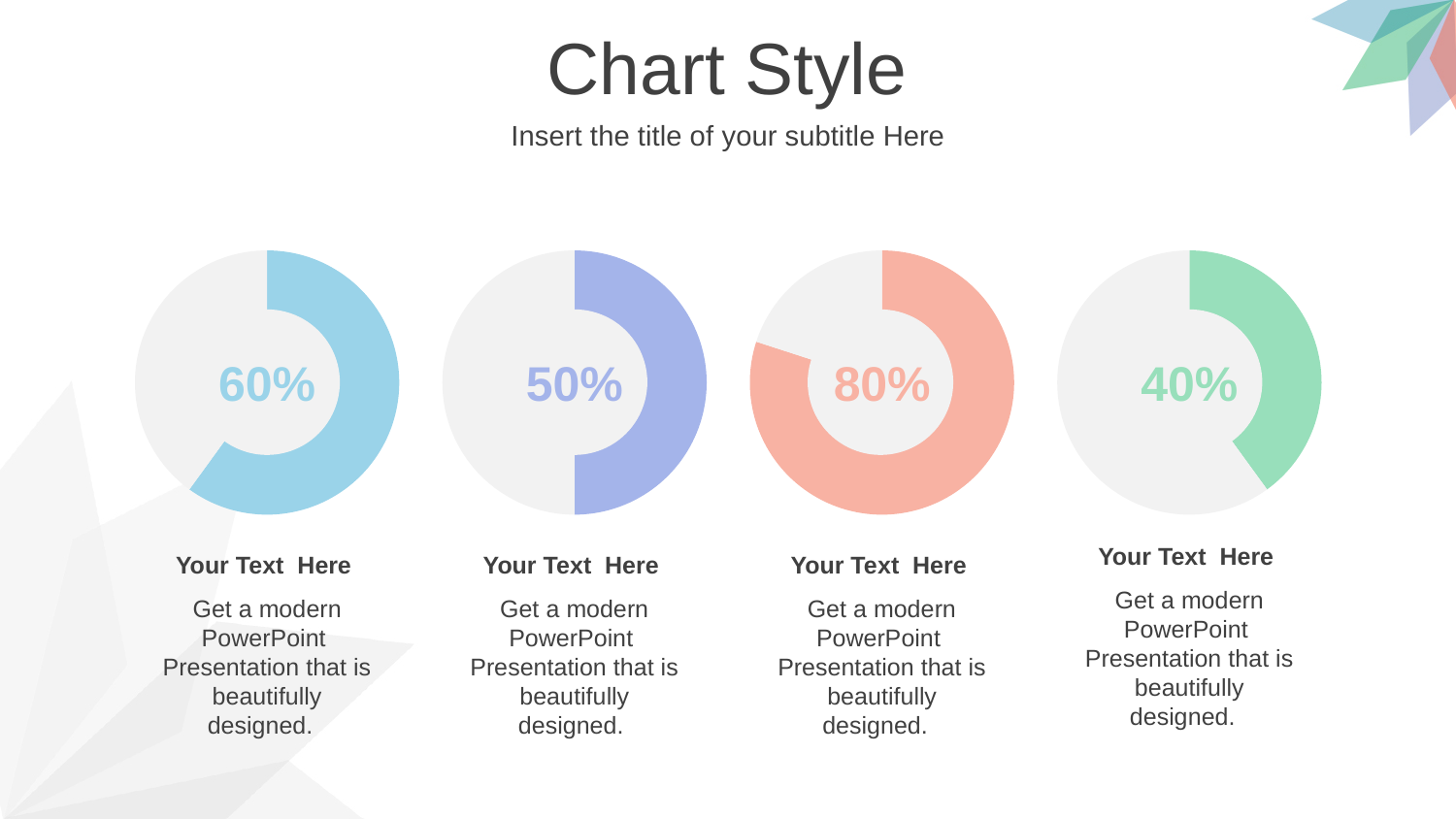
Which donut chart shows the lowest percentage? The rightmost (40%) What colour is the filled portion of the donut chart showing 80%? Salmon/pink What percentage is shown in the third donut chart from the left? 80% Which donut chart shows the highest percentage? The third from the left (80%) What is the difference between the percentage in the leftmost donut chart and the percentage in the second donut chart? 10% How many donut charts are on the slide? 4 What percentage is shown in the rightmost donut chart? 40% What kind of chart is used on this slide? Donut chart What percentage is shown in the leftmost donut chart? 60% What is the difference between the percentage in the third donut chart and the percentage in the rightmost donut chart? 40% Which is larger, the percentage in the leftmost donut chart or the percentage in the rightmost donut chart? The leftmost (60%) What percentage is shown in the second donut chart from the left? 50%